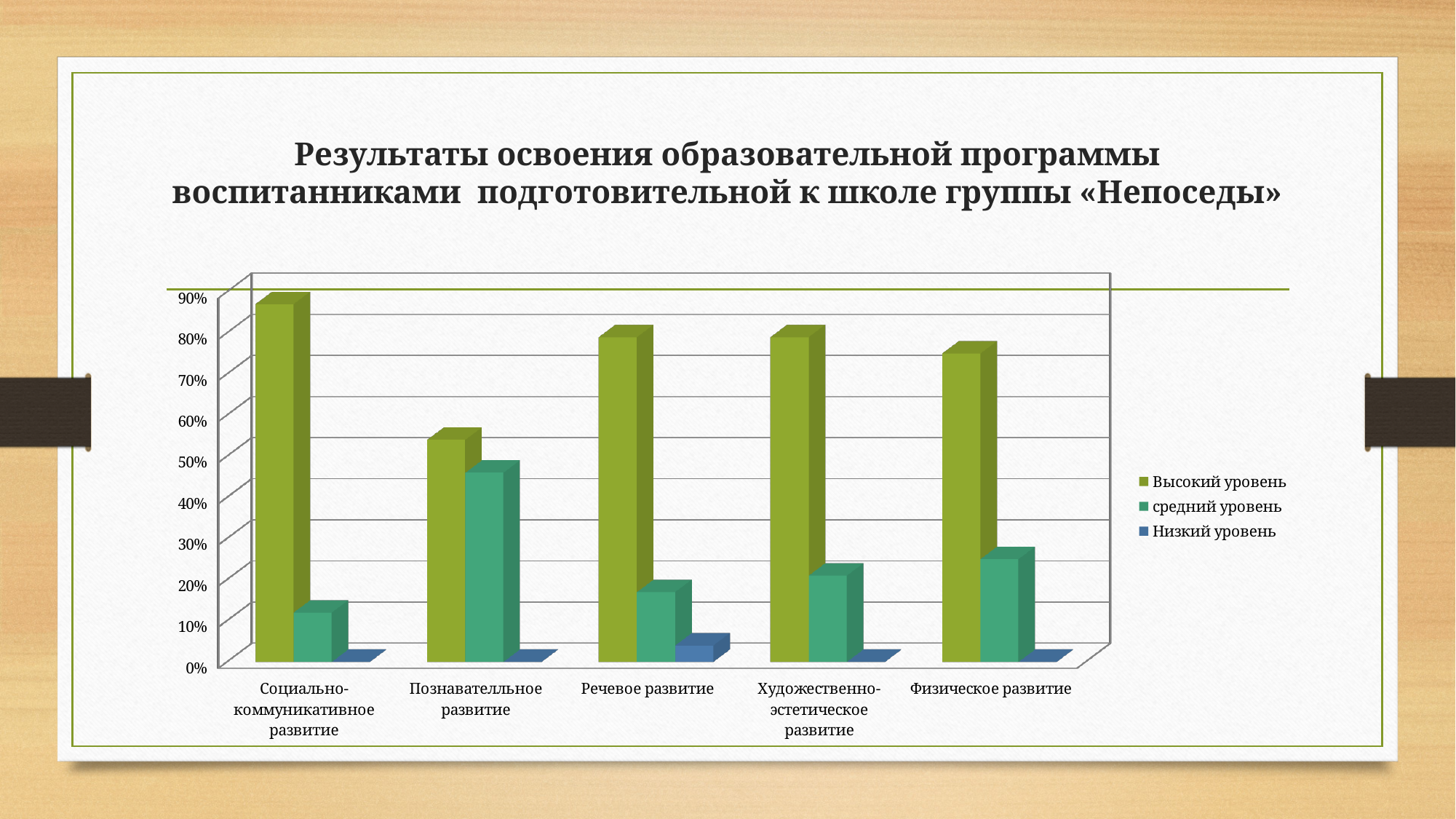
How many categories are shown on the x axis of the chart? 5 Which category has the lowest value for the series "Высокий уровень"? Познавательное развитие Is the value of "Высокий уровень" for "Социально-коммуникативное развитие" greater or less than 80%? greater Is the value of "Высокий уровень" for "Познавательное развитие" greater or less than 60%? less What kind of chart is shown on the slide? Bar chart Is the value of "средний уровень" for "Социально-коммуникативное развитие" greater or less than 20%? less Which category has the highest value for the series "Высокий уровень"? Социально-коммуникативное развитие Which is larger: the "средний уровень" value for "Физическое развитие" or for "Речевое развитие"? Физическое развитие What is the name of the third series listed in the chart's legend? Низкий уровень Which category has the highest value for the series "средний уровень"? Познавательное развитие How many series does the chart's legend list? 3